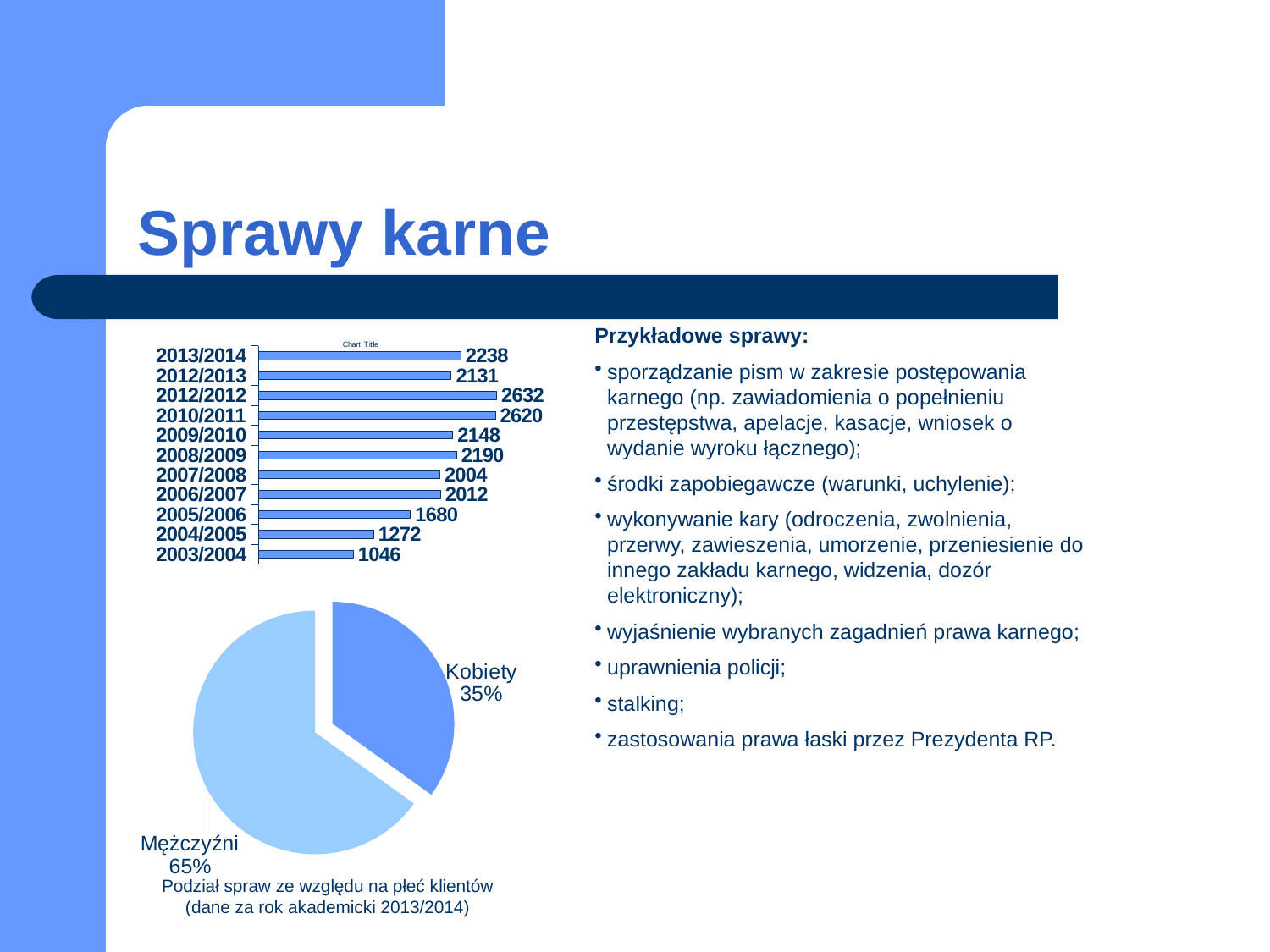
In the bar chart at the top left of the slide, what is the value for 2005/2006? 1680 What kind of chart is the chart at the top left of the slide? bar chart In the bar chart at the top left of the slide, what is the difference between the values for 2004/2005 and 2003/2004? 226 In the bar chart at the top left of the slide, which category has the lowest value? 2003/2004 In the bar chart at the top left of the slide, which is larger, the value for 2008/2009 or the value for 2009/2010? 2008/2009 In the bar chart at the top left of the slide, which category has the highest value? 2012/2012 How many categories are shown in the bar chart at the top left of the slide? 11 What kind of chart is the chart at the bottom left of the slide? pie chart In the pie chart at the bottom left of the slide, what share does Kobiety have? 35% In the bar chart at the top left of the slide, what is the value for 2013/2014? 2238 In the pie chart at the bottom left of the slide, what share does Mężczyźni have? 65% How many slices does the pie chart at the bottom left of the slide have? 2